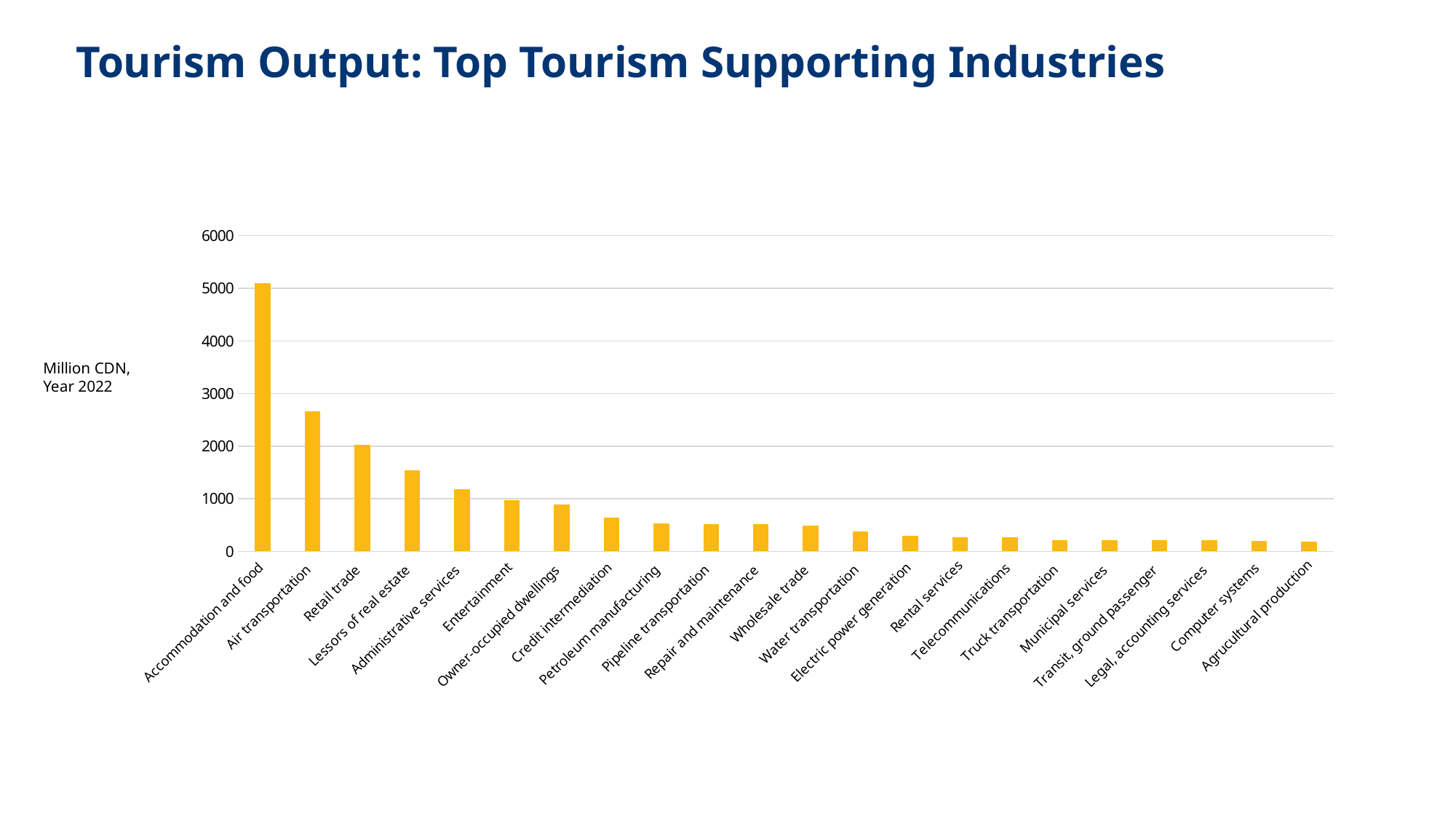
Is the value for Wholesale trade greater or less than 1000? less What unit and year are given for the values in the chart? Million CDN, Year 2022 Is the value for Owner-occupied dwellings greater or less than 1000? less Which industry has the highest tourism output in the chart? Accommodation and food Is the value for Accommodation and food greater or less than 4000? greater Which has a larger value, Air transportation or Retail trade? Air transportation Do the values rise or fall moving from left to right along the x axis? fall How many industries are shown on the x axis of the chart? 22 What type of chart is shown on the slide? bar chart